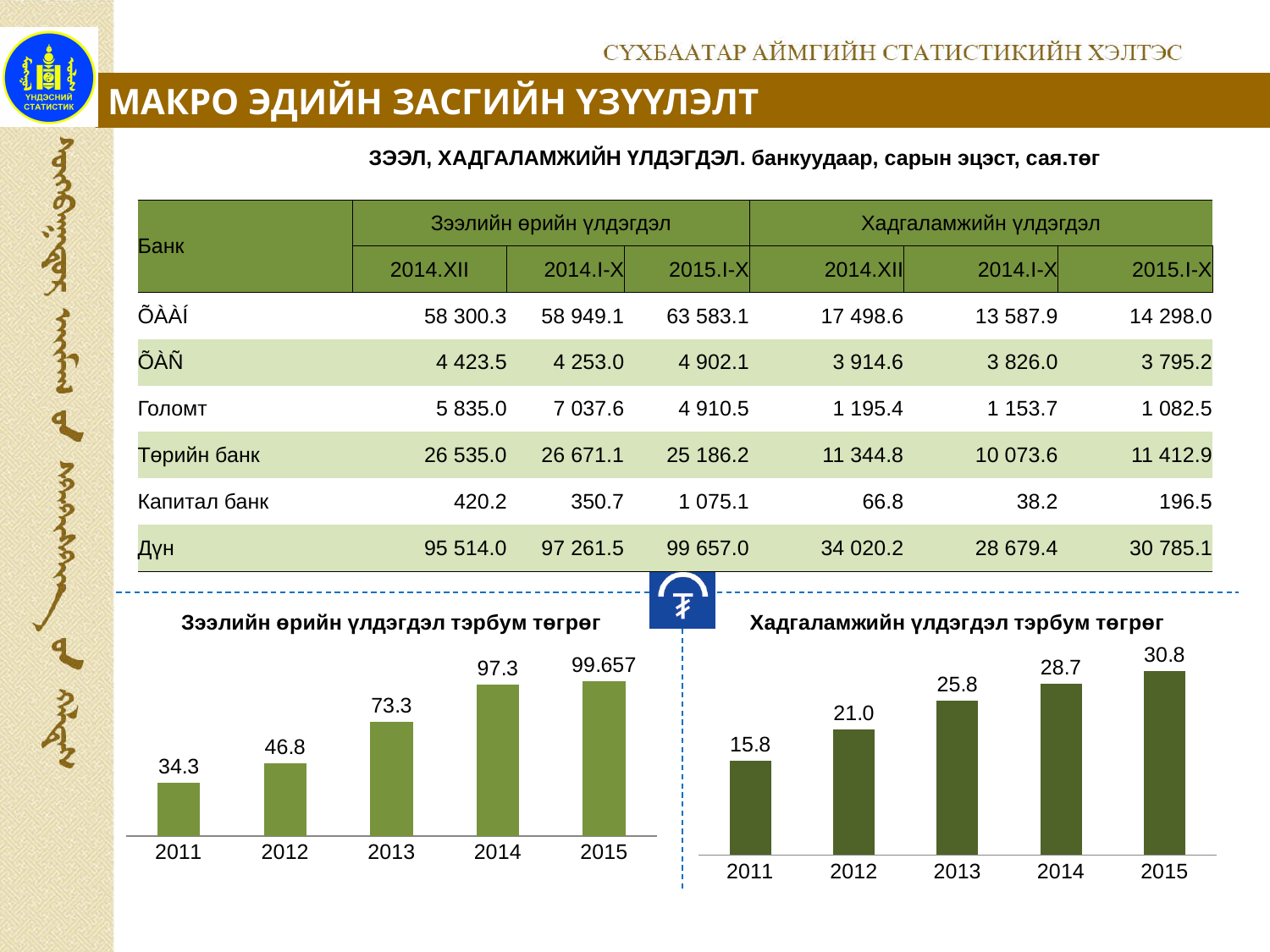
In the right chart (Хадгаламжийн үлдэгдэл тэрбум төгрөг), what is the difference between the 2013 and 2011 values? 10.0 In the right chart (Хадгаламжийн үлдэгдэл тэрбум төгрөг), what is the value for 2012? 21.0 In the left chart (Зээлийн өрийн үлдэгдэл тэрбум төгрөг), what is the value for 2013? 73.3 In the right chart (Хадгаламжийн үлдэгдэл тэрбум төгрөг), what is the value for 2015? 30.8 How many years are shown on the x axis of the right chart (Хадгаламжийн үлдэгдэл тэрбум төгрөг)? 5 What kind of chart is the left chart (Зээлийн өрийн үлдэгдэл тэрбум төгрөг)? Bar chart In the right chart (Хадгаламжийн үлдэгдэл тэрбум төгрөг), do the values rise or fall from 2011 to 2015? Rise In the left chart (Зээлийн өрийн үлдэгдэл тэрбум төгрөг), which is larger, the value for 2012 or the value for 2013? 2013 In the left chart (Зээлийн өрийн үлдэгдэл тэрбум төгрөг), what is the difference between the 2014 and 2013 values? 24.0 In the left chart (Зээлийн өрийн үлдэгдэл тэрбум төгрөг), what is the value for 2015? 99.657 In the left chart (Зээлийн өрийн үлдэгдэл тэрбум төгрөг), which year has the lowest value? 2011 In the right chart (Хадгаламжийн үлдэгдэл тэрбум төгрөг), which year has the highest value? 2015